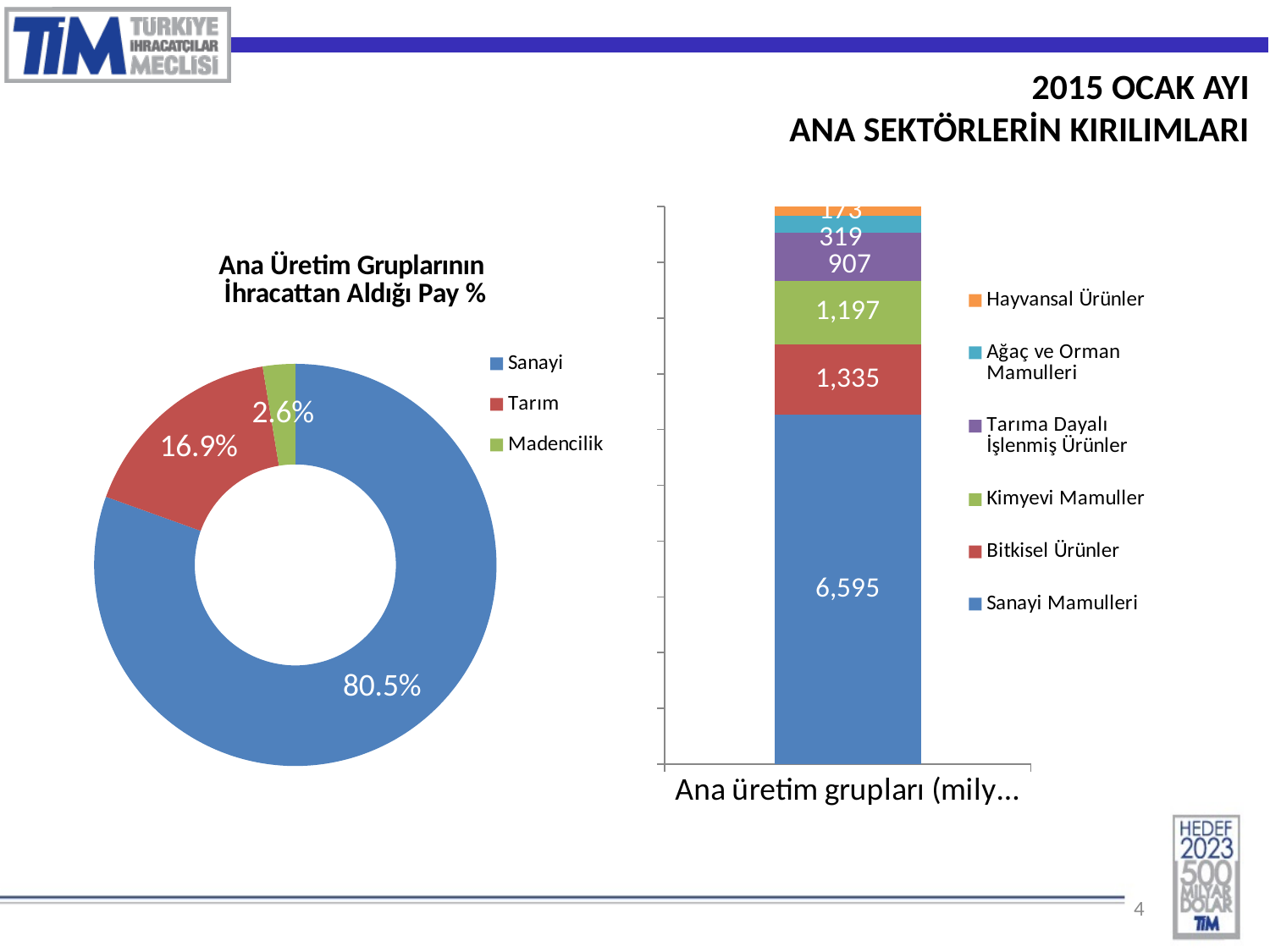
In the stacked bar chart on the right, what is the value for Bitkisel Ürünler? 1,335 In the stacked bar chart on the right, what is the value for Tarıma Dayalı İşlenmiş Ürünler? 907 In the doughnut chart 'Ana Üretim Gruplarının İhracattan Aldığı Pay %', what share does Tarım have? 16.9% How many entries does the legend of the doughnut chart on the left list? 3 In the stacked bar chart on the right, what is the value for Sanayi Mamulleri? 6,595 In the stacked bar chart on the right, what is the difference between the values for Bitkisel Ürünler and Kimyevi Mamuller? 138 In the doughnut chart on the left, how many percentage points larger is the Sanayi share than the Tarım share? 63.6 In the doughnut chart on the left, which group has the smallest share? Madencilik In the doughnut chart 'Ana Üretim Gruplarının İhracattan Aldığı Pay %', what share does Madencilik have? 2.6% In the doughnut chart 'Ana Üretim Gruplarının İhracattan Aldığı Pay %', what share does Sanayi have? 80.5% In the stacked bar chart on the right, what is the value for Kimyevi Mamuller? 1,197 In the stacked bar chart on the right, which is larger: Tarıma Dayalı İşlenmiş Ürünler or Ağaç ve Orman Mamulleri? Tarıma Dayalı İşlenmiş Ürünler